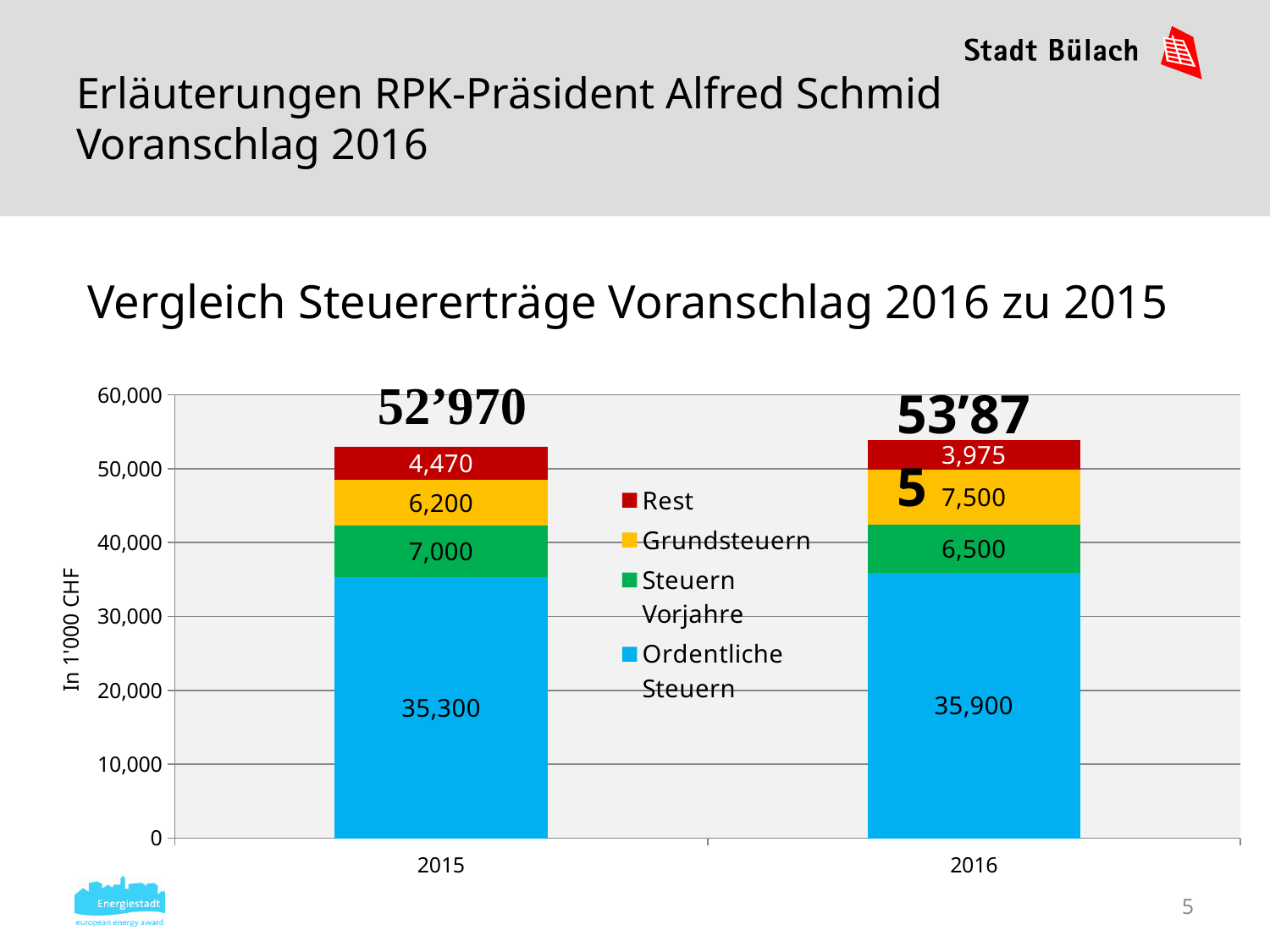
Which is larger: Grundsteuern in 2015 or Grundsteuern in 2016? Grundsteuern in 2016 Which series has the largest value in the 2016 bar? Ordentliche Steuern How many series does the legend list? 4 What is the value for Grundsteuern in 2016? 7,500 What is the difference between Ordentliche Steuern in 2016 and in 2015? 600 What is the total of the stacked bar for 2015? 52'970 What is the value for Rest in 2015? 4,470 Which series has the smallest value in the 2016 bar? Rest What kind of chart is shown on the slide? Stacked bar chart How many categories are shown on the x axis? 2 What is the value for Ordentliche Steuern in 2015? 35,300 What is the value for Steuern Vorjahre in 2016? 6,500